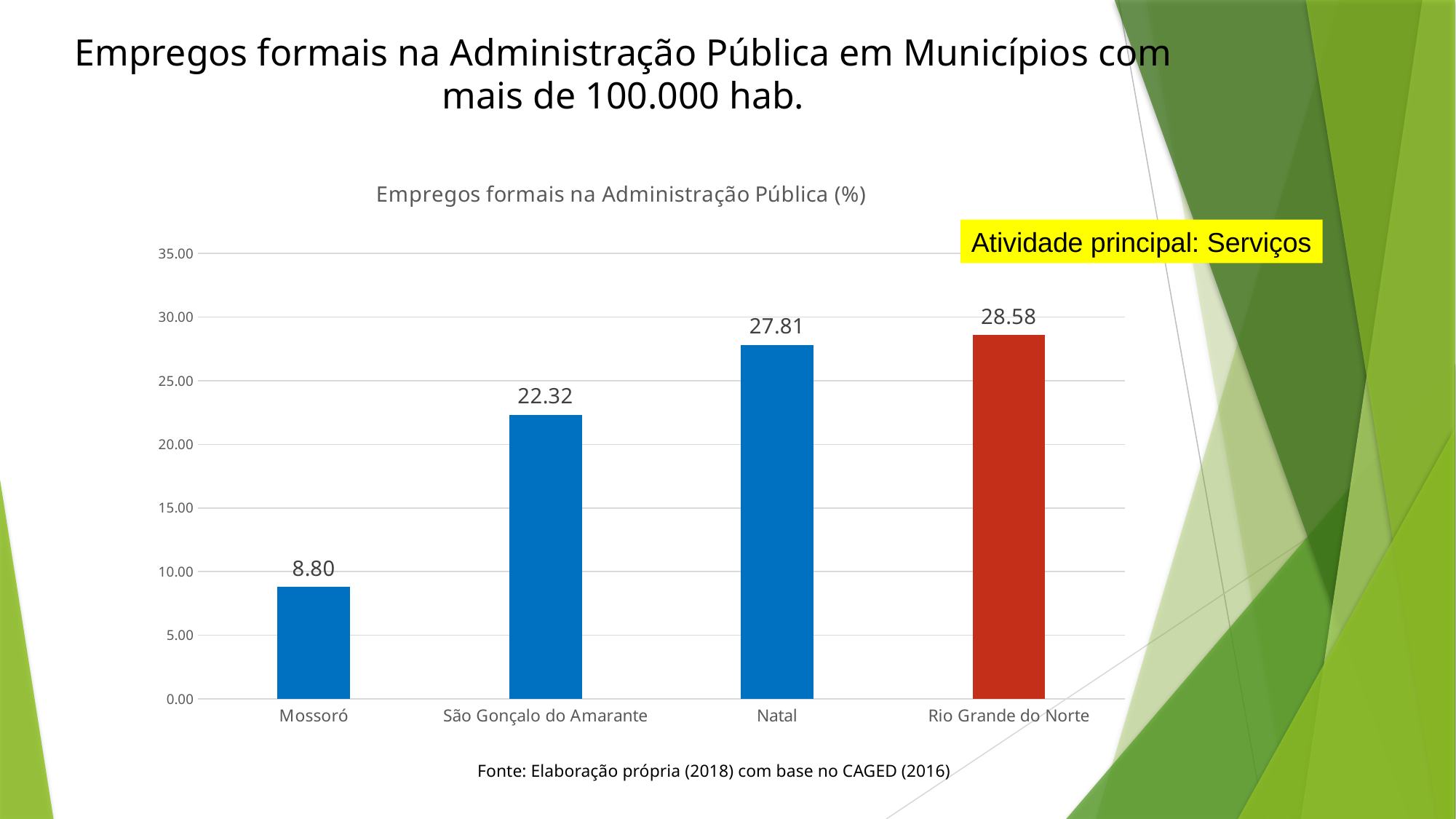
What is the title of the chart? Empregos formais na Administração Pública (%) What is the difference between the values for Rio Grande do Norte and Mossoró? 19.78 Which is larger, the value for São Gonçalo do Amarante or the value for Mossoró? São Gonçalo do Amarante What kind of chart is shown on the slide? Bar chart Which category has the highest value? Rio Grande do Norte How many categories are shown on the x axis? 4 What is the difference between the values for Natal and São Gonçalo do Amarante? 5.49 What is the value for Mossoró? 8.80 Which category has the lowest value? Mossoró What is the value for Natal? 27.81 What is the value for São Gonçalo do Amarante? 22.32 What is the value for Rio Grande do Norte? 28.58